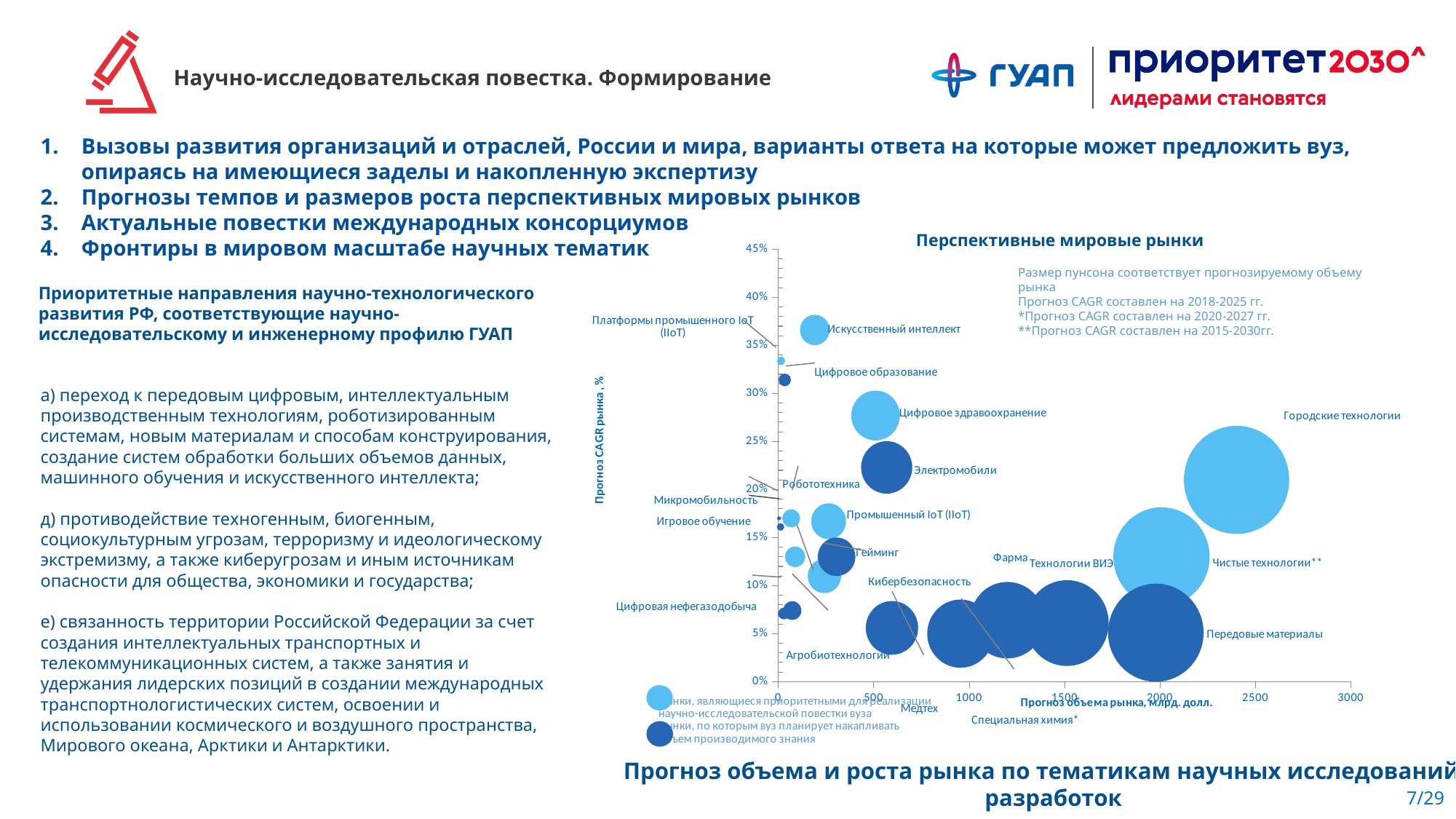
Is the forecast market volume for Агробиотехнологии greater or less than 1000? less What is the label of the horizontal axis of the bubble chart? Прогноз объема рынка, млрд. долл. Which has the higher forecast CAGR on the bubble chart, Электромобили or Передовые материалы? Электромобили Which market on the bubble chart has the highest forecast CAGR? Искусственный интеллект Is the forecast CAGR for Искусственный интеллект greater or less than 30%? greater Which market on the bubble chart has the largest forecast market volume (furthest right)? Городские технологии Is the forecast CAGR for Передовые материалы greater or less than 10%? less What is the label of the vertical axis of the bubble chart? Прогноз CAGR рынка, % What kind of chart is shown under the title "Перспективные мировые рынки"? bubble chart Which has the larger forecast market volume on the bubble chart, Чистые технологии or Цифровое здравоохранение? Чистые технологии